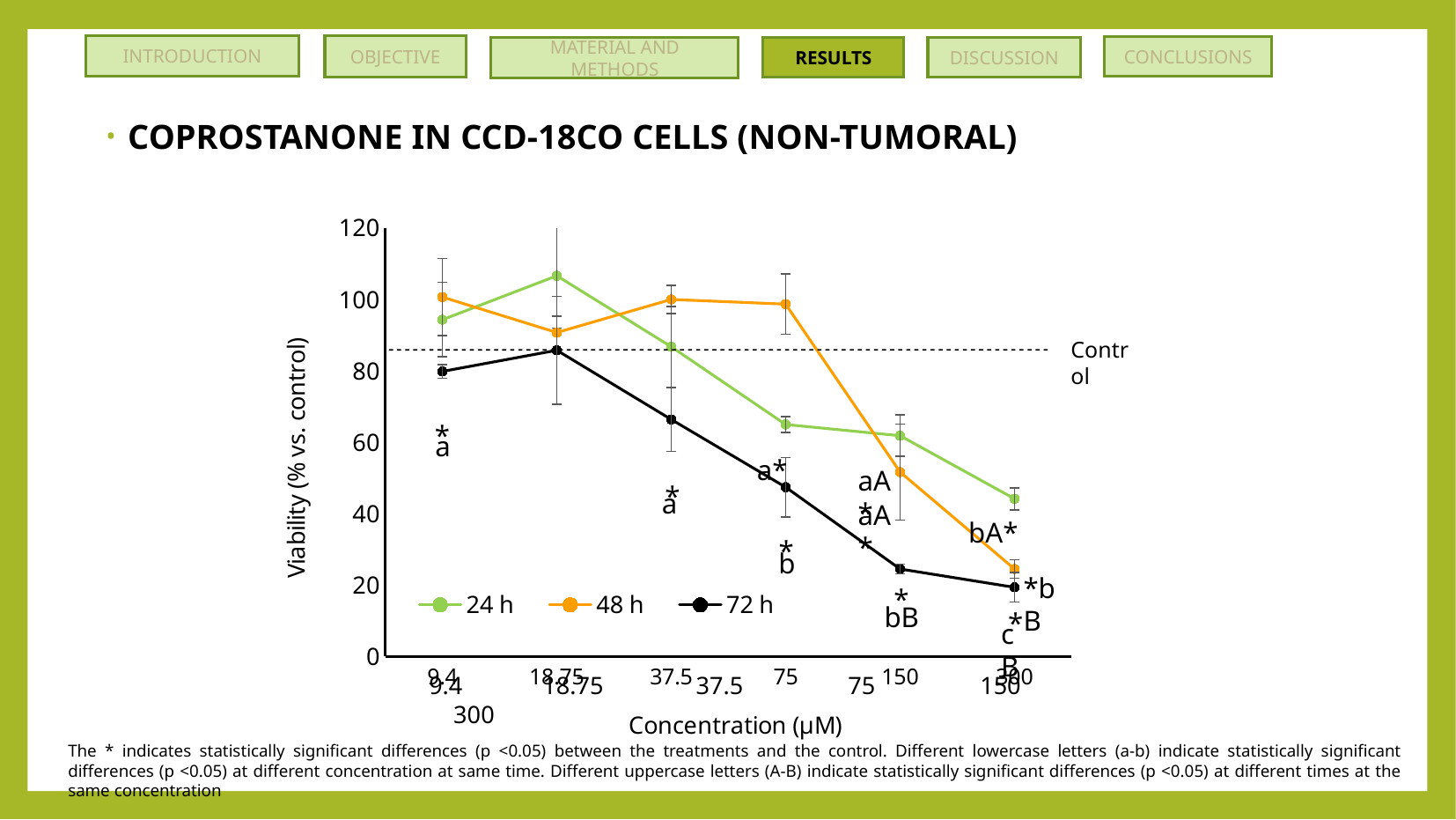
What kind of chart is shown on the slide? line chart At 9.4 µM, which series has the higher viability, 48 h or 72 h? 48 h Is the 24 h viability at 150 µM greater or less than 80? less At which concentration is the 72 h viability lowest? 300 What is the title of the y axis? Viability (% vs. control) Is the 48 h viability at 75 µM greater or less than 80? greater Is the 72 h viability at 300 µM greater or less than 40? less At 300 µM, which series has the higher viability, 24 h or 48 h? 24 h How many concentration points are plotted along the x axis? 6 How many series does the legend list? 3 At which concentration is the 24 h viability highest? 18.75 Does the 72 h viability rise or fall as concentration increases from 18.75 µM to 300 µM? fall